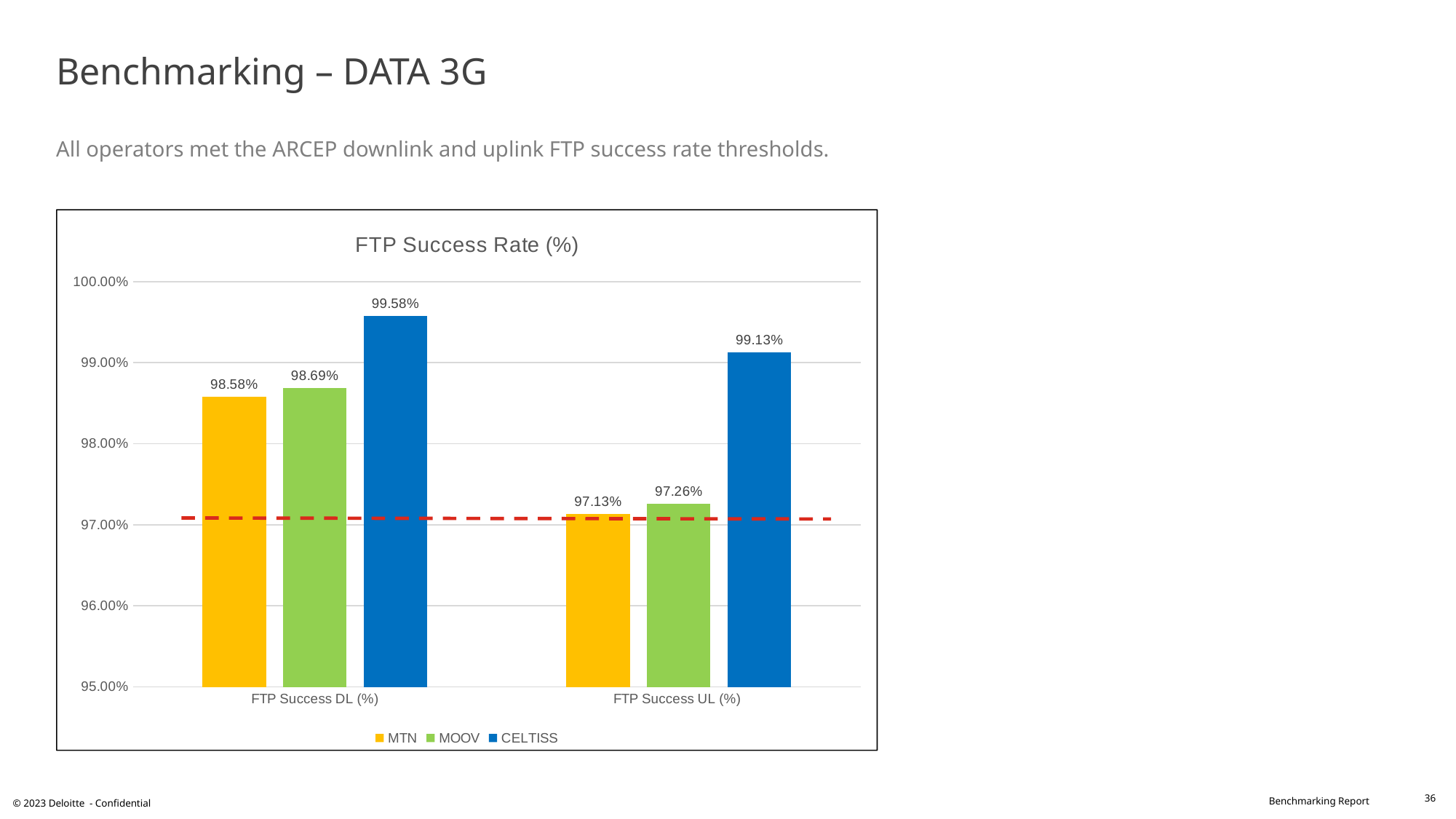
How many categories are shown on the x axis? 2 What is the FTP Success DL (%) value for CELTISS? 99.58% Which operator has the highest FTP Success UL (%)? CELTISS What type of chart is shown on the slide? Bar chart Which operator has the lowest FTP Success DL (%)? MTN Is the FTP Success UL (%) value for CELTISS greater or less than 99.00%? greater Which is larger: CELTISS's FTP Success DL (%) or CELTISS's FTP Success UL (%)? FTP Success DL (%) How many series does the legend list? 3 What is the difference between CELTISS and MTN for FTP Success DL (%)? 1.00% What is the FTP Success DL (%) value for MOOV? 98.69% What is the FTP Success UL (%) value for MTN? 97.13% What is the difference between MOOV and MTN for FTP Success UL (%)? 0.13%